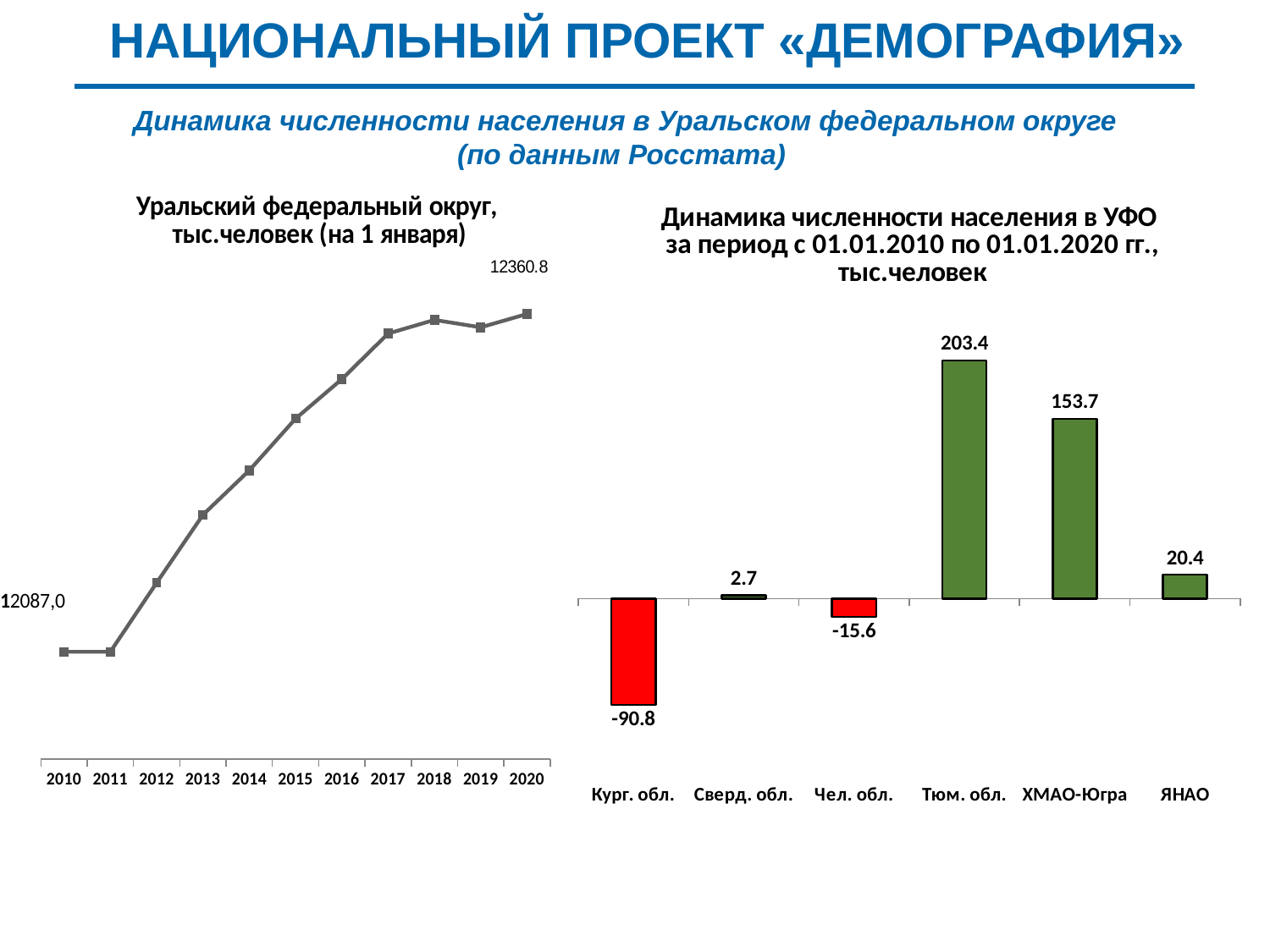
How many regions are shown in the right chart 'Динамика численности населения в УФО'? 6 What kind of chart is the right chart 'Динамика численности населения в УФО'? Bar chart In the right chart 'Динамика численности населения в УФО', what is the difference between the values for Тюм. обл. and ХМАО-Югра? 49.7 In the left chart 'Уральский федеральный округ, тыс.человек (на 1 января)', what is the value for 2020? 12360.8 In the right chart 'Динамика численности населения в УФО', what is the value for Кург. обл.? -90.8 In the right chart 'Динамика численности населения в УФО', which is larger: the value for Сверд. обл. or the value for ЯНАО? ЯНАО In the right chart 'Динамика численности населения в УФО', what is the value for Тюм. обл.? 203.4 In the right chart 'Динамика численности населения в УФО', which region has the highest value? Тюм. обл. In the left chart 'Уральский федеральный округ, тыс.человек (на 1 января)', do the values generally rise or fall from 2010 to 2020? Rise In the right chart 'Динамика численности населения в УФО', which region has the lowest value? Кург. обл. In the right chart 'Динамика численности населения в УФО', what is the value for ЯНАО? 20.4 How many years are shown on the x axis of the left chart 'Уральский федеральный округ, тыс.человек (на 1 января)'? 11